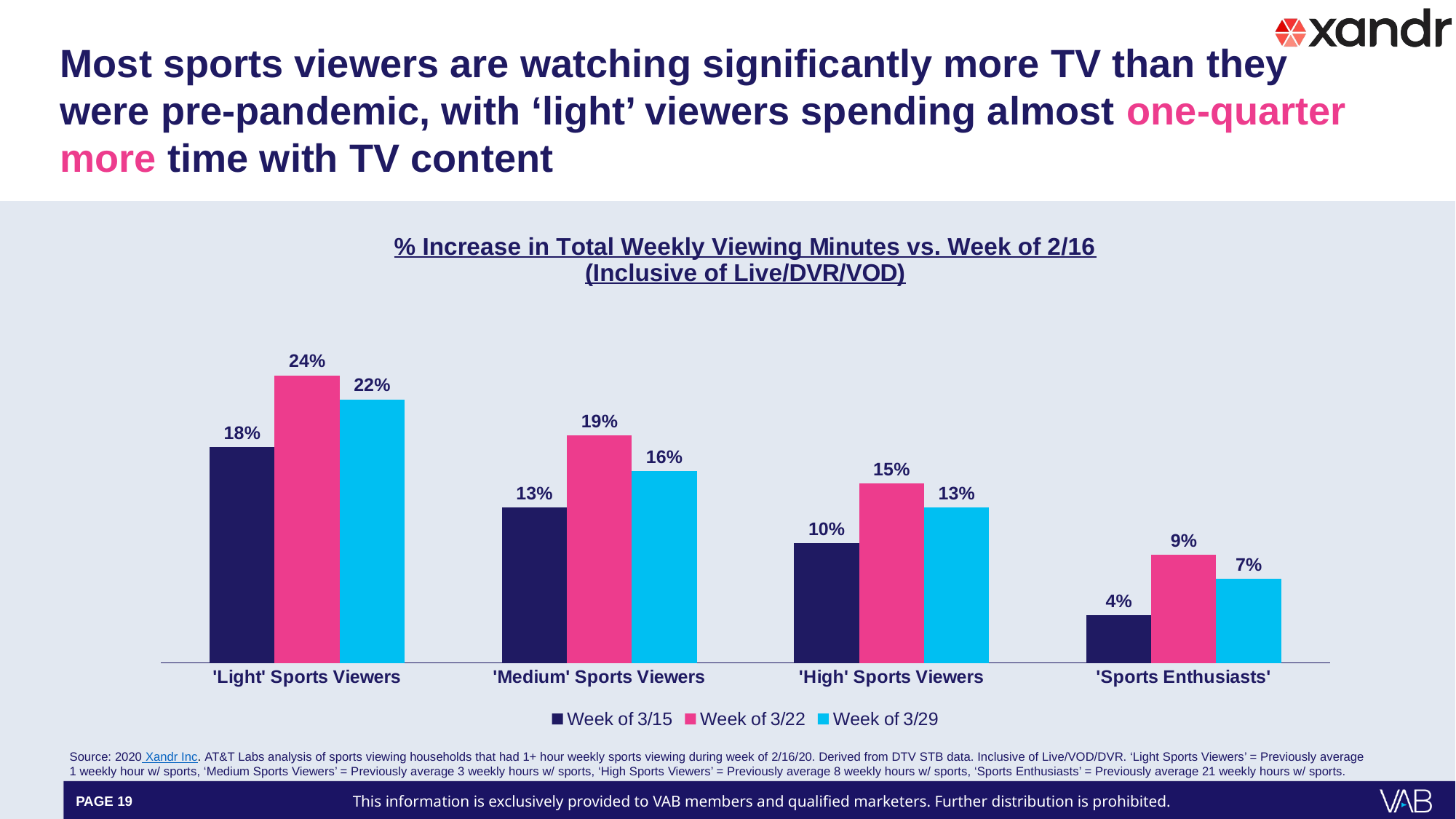
How many series does the legend list? 3 Which category has the highest value in the Week of 3/22 series? 'Light' Sports Viewers How many viewer categories are shown on the x axis? 4 Which category has the lowest value in the Week of 3/29 series? 'Sports Enthusiasts' What kind of chart is shown on the slide? Bar chart What is the value for 'Light' Sports Viewers in the Week of 3/22 series? 24% Do the Week of 3/15 values rise or fall moving from 'Light' Sports Viewers to 'Sports Enthusiasts'? Fall Which is larger for 'High' Sports Viewers: the Week of 3/15 value or the Week of 3/29 value? Week of 3/29 What is the value for 'High' Sports Viewers in the Week of 3/29 series? 13% What is the title of the chart? % Increase in Total Weekly Viewing Minutes vs. Week of 2/16 (Inclusive of Live/DVR/VOD) What is the difference between the Week of 3/22 and Week of 3/15 values for 'Medium' Sports Viewers? 6% What is the value for 'Sports Enthusiasts' in the Week of 3/15 series? 4%